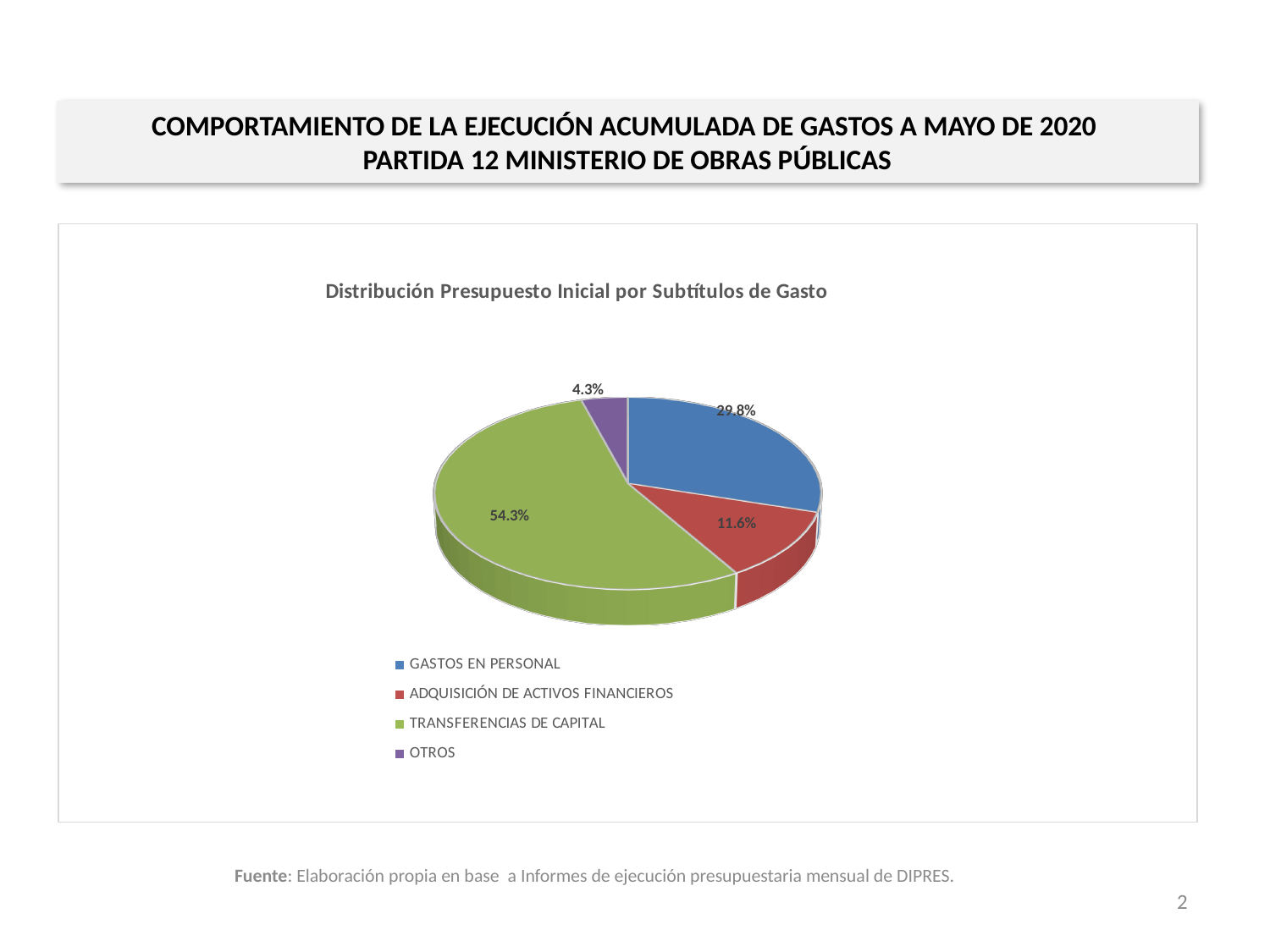
What is the title of the chart? Distribución Presupuesto Inicial por Subtítulos de Gasto How many categories are shown in the pie chart? 4 Which is larger, the share for GASTOS EN PERSONAL or the share for ADQUISICIÓN DE ACTIVOS FINANCIEROS? GASTOS EN PERSONAL Which category has the largest slice of the pie? TRANSFERENCIAS DE CAPITAL What colour is the slice for TRANSFERENCIAS DE CAPITAL? Green What share of the pie does OTROS represent? 4.3% What is the difference in percentage points between TRANSFERENCIAS DE CAPITAL and GASTOS EN PERSONAL? 24.5 What share of the pie does TRANSFERENCIAS DE CAPITAL represent? 54.3% What share of the pie does GASTOS EN PERSONAL represent? 29.8% What kind of chart is shown on the slide? Pie chart Which category has the smallest slice of the pie? OTROS